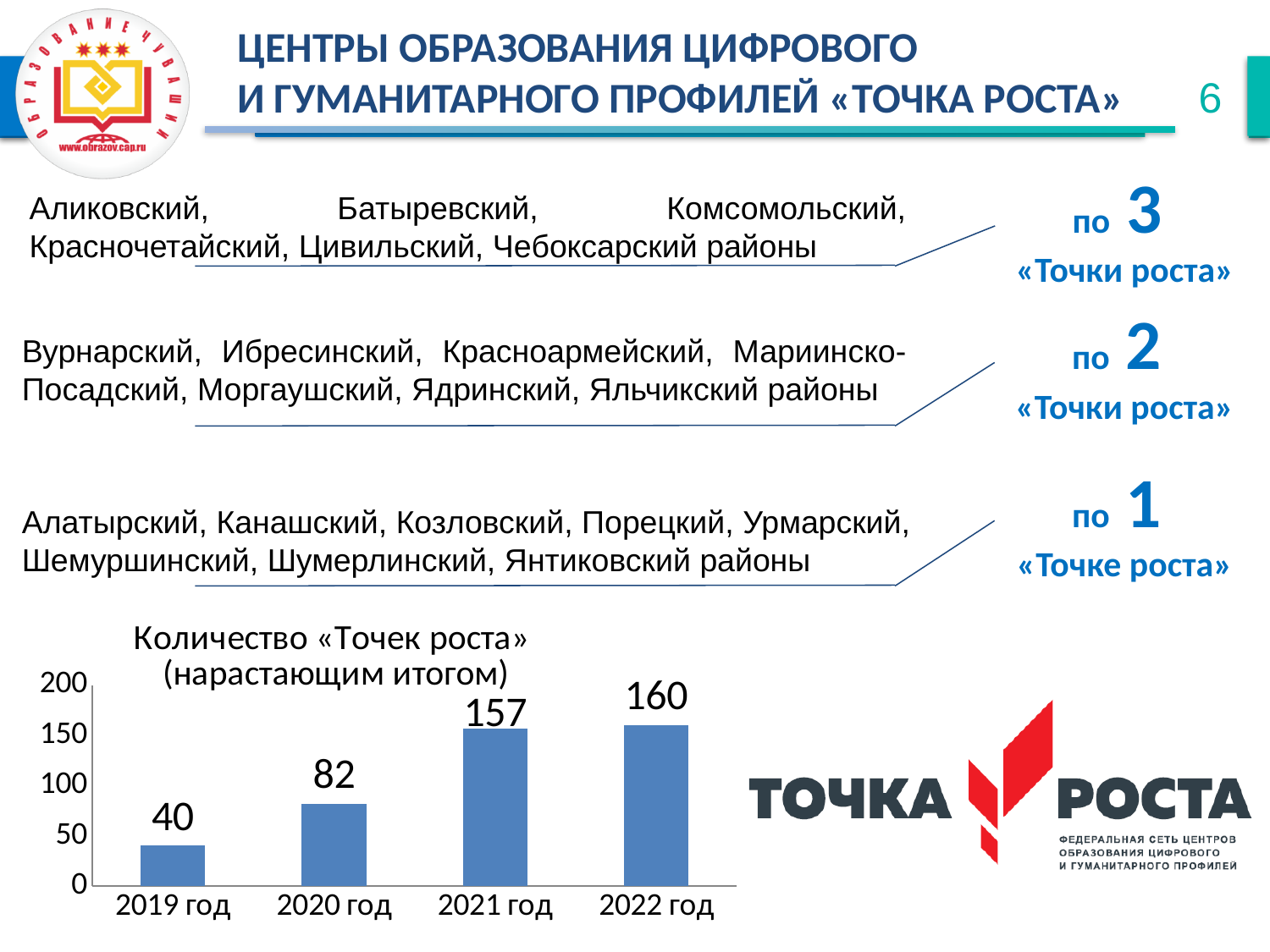
Which year has the lowest value in the chart? 2019 год Which year has the highest value in the chart? 2022 год What kind of chart is shown on the slide? Bar chart How many years (categories) are shown in the chart? 4 What is the difference between the values for 2022 год and 2019 год? 120 What is the value for 2022 год in the chart? 160 What is the value for 2019 год in the chart? 40 What is the value for 2021 год in the chart? 157 What is the value for 2020 год in the chart? 82 Do the values rise or fall from 2019 год to 2022 год? Rise Which is larger, the value for 2020 год or the value for 2019 год? 2020 год What is the difference between the values for 2021 год and 2020 год? 75